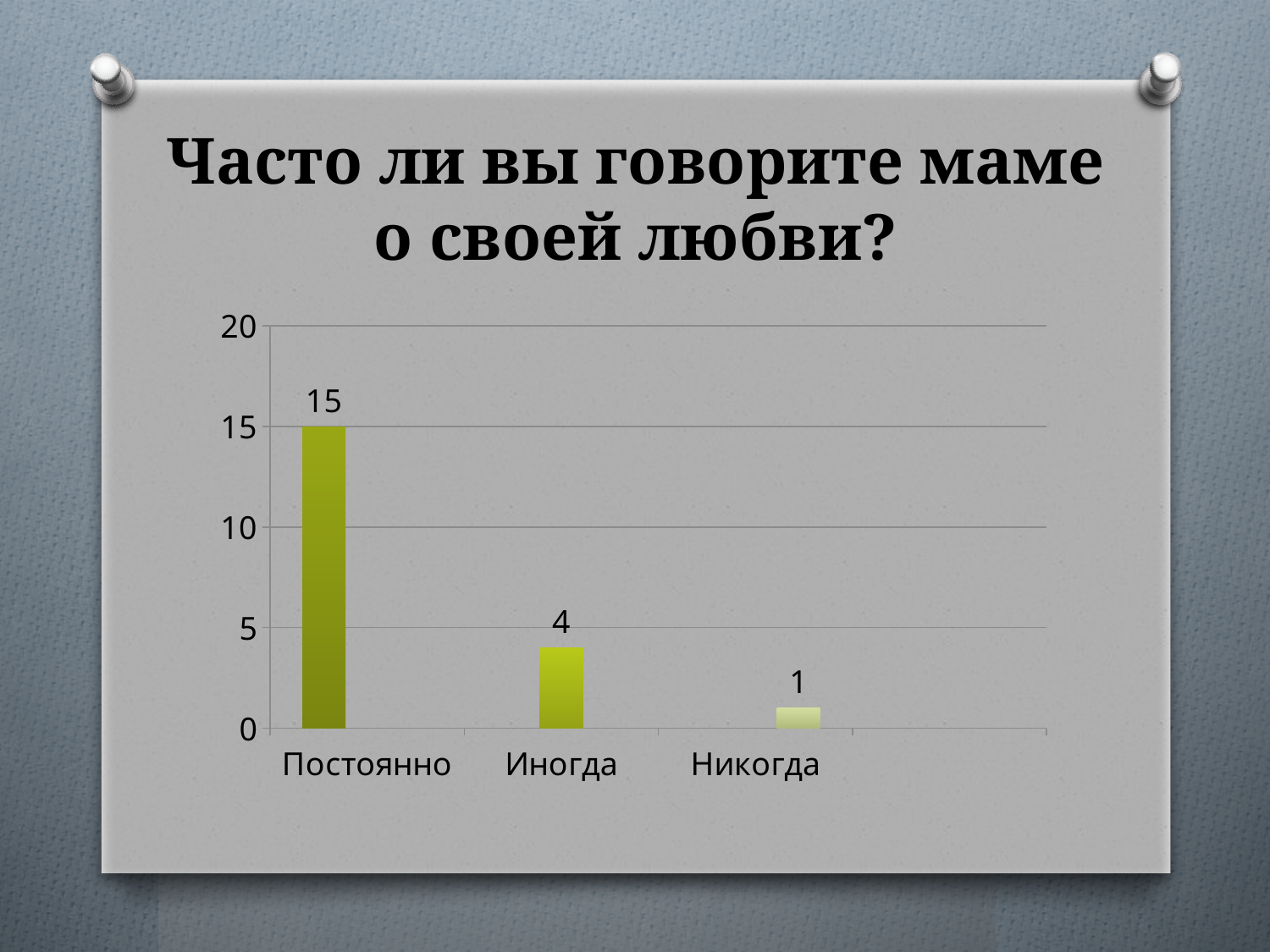
What is the value for Постоянно? 15 What is the title of the slide above the chart? Часто ли вы говорите маме о своей любви? What is the difference between the values for Постоянно and Иногда? 11 What kind of chart is shown on the slide? bar chart How many categories are shown on the x axis? 3 Which is larger, the value for Иногда or the value for Никогда? Иногда Which category has the highest value? Постоянно Which category has the lowest value? Никогда What is the value for Иногда? 4 What is the value for Никогда? 1 What is the difference between the values for Иногда and Никогда? 3 Is the value for Постоянно greater or less than 10? greater